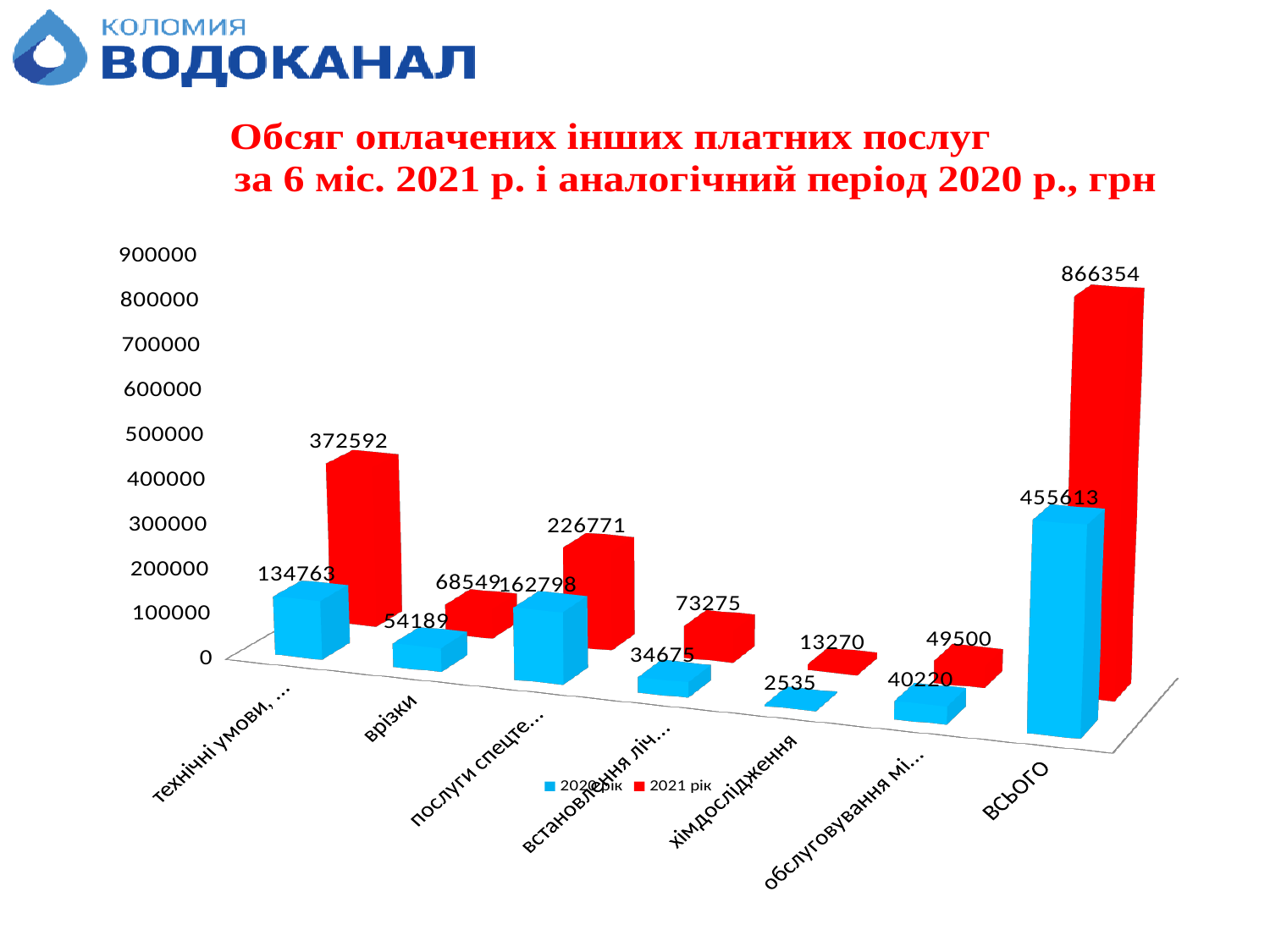
How many series does the legend list? 2 What is the difference between the 2021 рік and 2020 рік values for врізки? 14360 For хімдослідження, which series has the larger value, 2020 рік or 2021 рік? 2021 рік How many categories are shown on the x axis? 7 What kind of chart is shown on the slide? bar chart What is the value for ВСЬОГО in the 2021 рік series? 866354 Which category has the lowest value in the 2020 рік series? хімдослідження What is the value for ВСЬОГО in the 2020 рік series? 455613 What is the value for врізки in the 2020 рік series? 54189 What is the difference between the 2021 рік and 2020 рік values for ВСЬОГО? 410741 Which category has the highest value in the 2021 рік series? ВСЬОГО What is the value for хімдослідження in the 2021 рік series? 13270